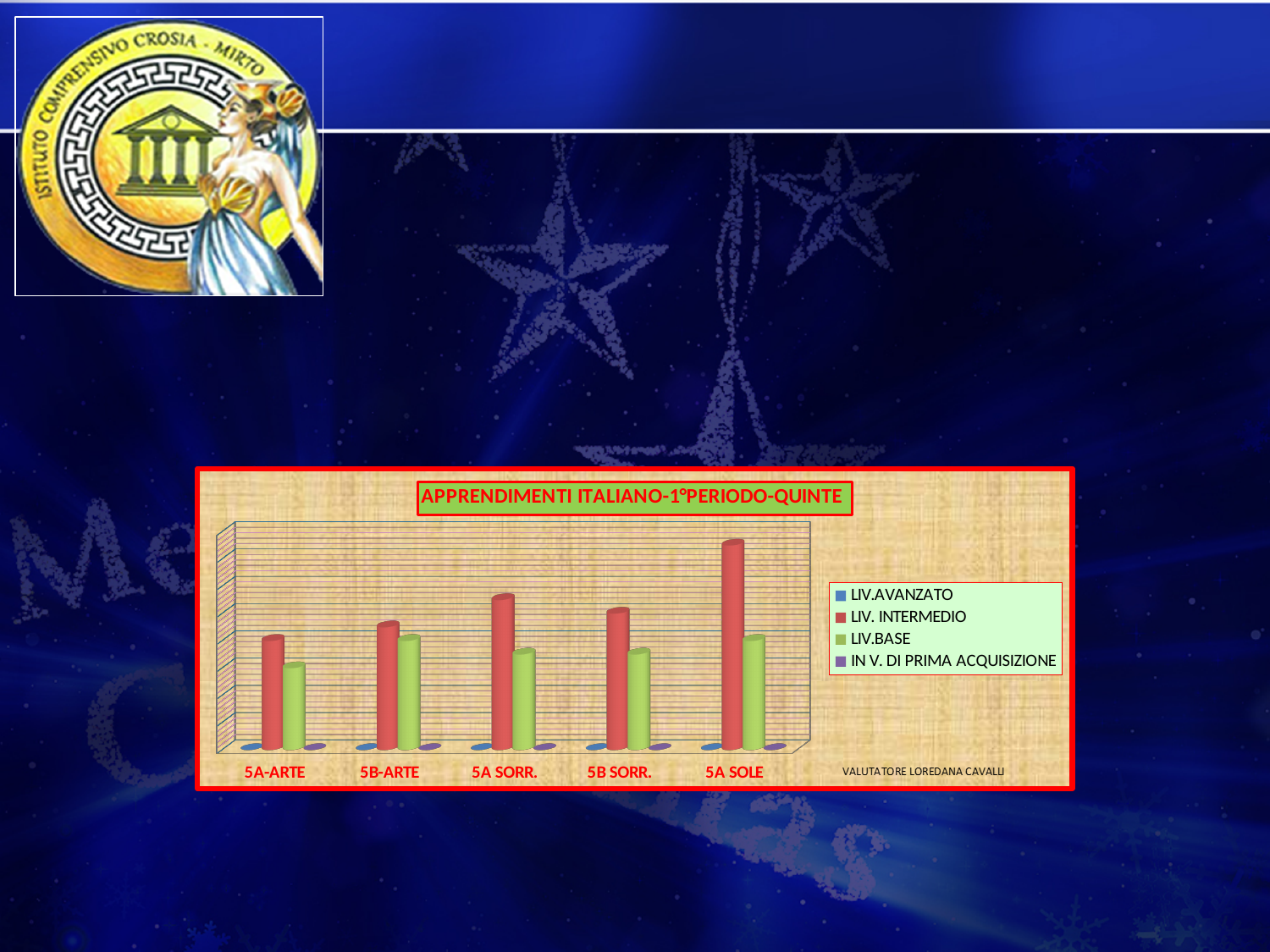
For 5A-ARTE, which is larger: the LIV. INTERMEDIO bar or the LIV.BASE bar? LIV. INTERMEDIO How many series does the chart legend list? 4 Which class has the highest LIV. INTERMEDIO bar? 5A SOLE Which class has the lowest LIV.BASE bar? 5A-ARTE Which is larger: the LIV. INTERMEDIO bar for 5A SOLE or the LIV. INTERMEDIO bar for 5A-ARTE? 5A SOLE What colour represents LIV.BASE in the chart legend? Green How many classes (categories) are shown on the x axis of the chart? 5 For 5A SOLE, which is larger: the LIV. INTERMEDIO bar or the LIV.BASE bar? LIV. INTERMEDIO What kind of chart is shown on the slide? Bar chart What is the title of the chart? APPRENDIMENTI ITALIANO-1°PERIODO-QUINTE Which series has the tallest bar in every class shown? LIV. INTERMEDIO